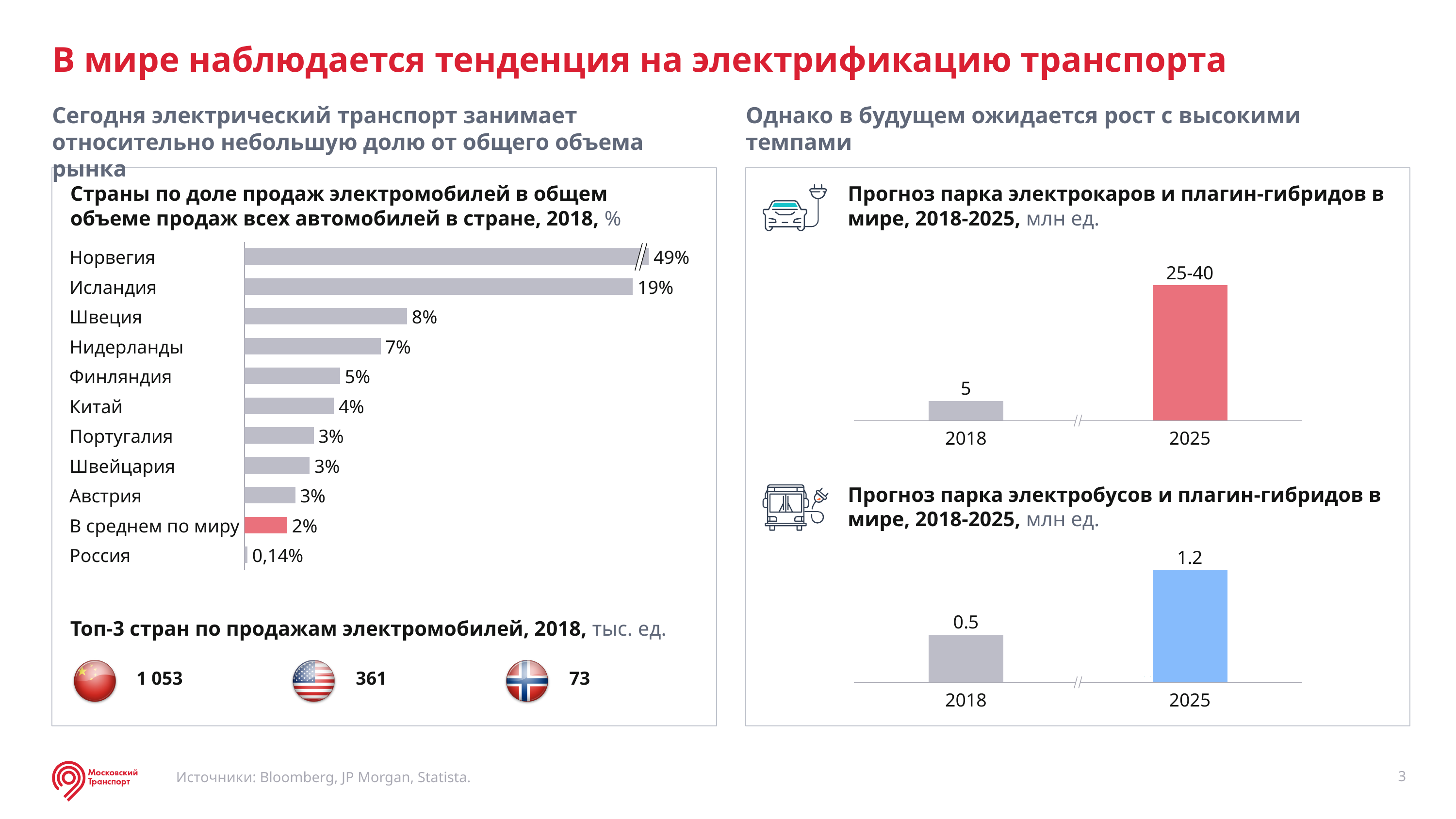
In the chart 'Страны по доле продаж электромобилей в общем объеме продаж всех автомобилей в стране, 2018', which bar is highlighted in red? В среднем по миру In the chart 'Страны по доле продаж электромобилей в общем объеме продаж всех автомобилей в стране, 2018', what is the difference between Исландия and Швеция? 11% How many categories are shown in the chart 'Страны по доле продаж электромобилей в общем объеме продаж всех автомобилей в стране, 2018'? 11 In the chart 'Страны по доле продаж электромобилей в общем объеме продаж всех автомобилей в стране, 2018', what is the value for Норвегия? 49% In the chart 'Прогноз парка электробусов и плагин-гибридов в мире, 2018-2025', do values rise or fall from 2018 to 2025? Rise In the chart 'Прогноз парка электробусов и плагин-гибридов в мире, 2018-2025', what is the value for 2018? 0.5 In the chart 'Страны по доле продаж электромобилей в общем объеме продаж всех автомобилей в стране, 2018', which is larger: Нидерланды or Финляндия? Нидерланды In the chart 'Страны по доле продаж электромобилей в общем объеме продаж всех автомобилей в стране, 2018', which country has the lowest share? Россия In the chart 'Прогноз парка электрокаров и плагин-гибридов в мире, 2018-2025', what is the value for 2025? 25-40 What type of chart is 'Страны по доле продаж электромобилей в общем объеме продаж всех автомобилей в стране, 2018'? Bar chart In the chart 'Страны по доле продаж электромобилей в общем объеме продаж всех автомобилей в стране, 2018', what is the value for Россия? 0,14% In the chart 'Страны по доле продаж электромобилей в общем объеме продаж всех автомобилей в стране, 2018', which category has the highest share? Норвегия